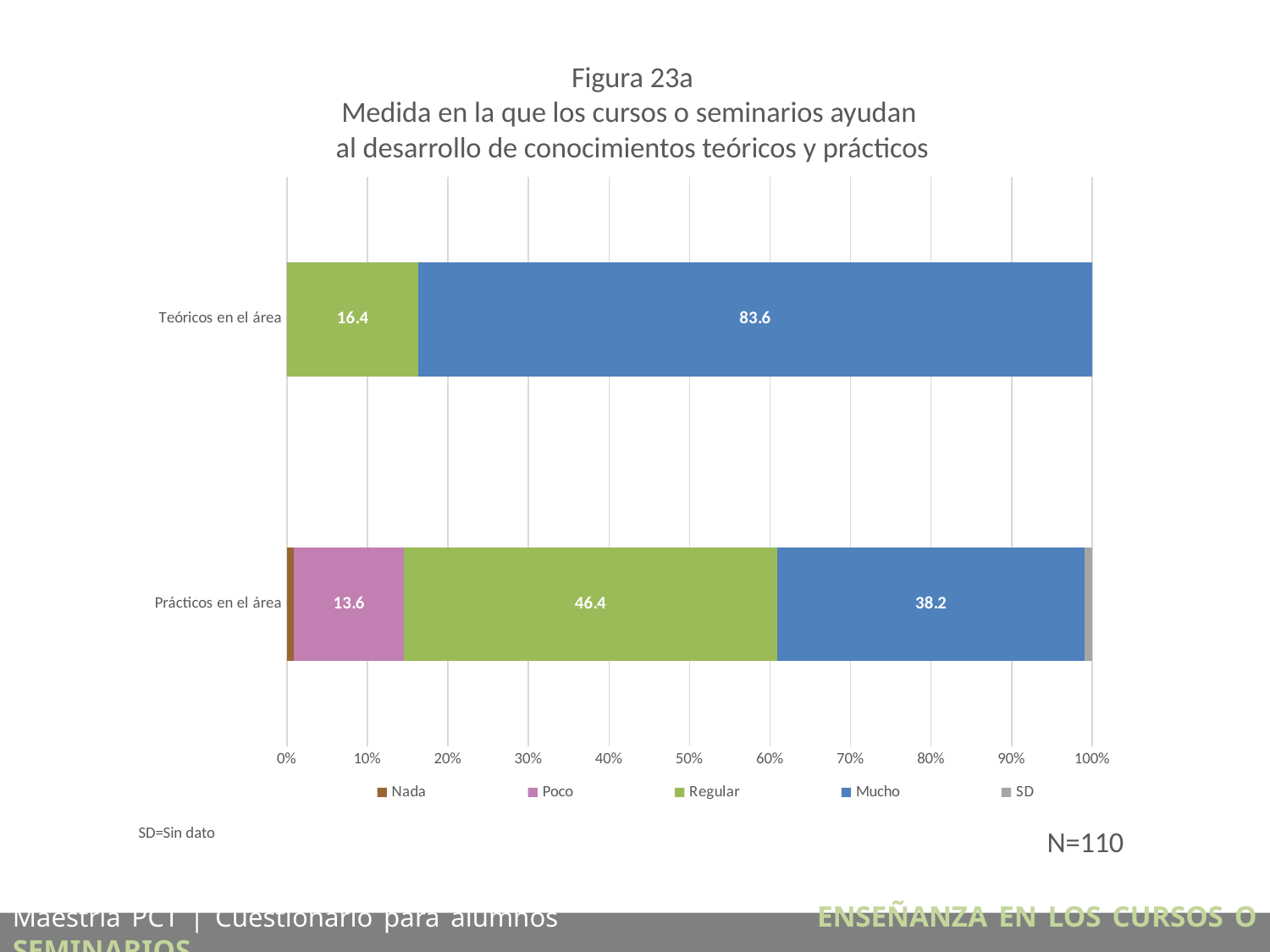
What is the value for Mucho in the Teóricos en el área bar? 83.6 How many categories are shown on the chart? 2 Which category has the larger value for Mucho, Teóricos en el área or Prácticos en el área? Teóricos en el área What is the value for Poco in the Prácticos en el área bar? 13.6 What is the value for Regular in the Prácticos en el área bar? 46.4 Is the value for Nada in the Prácticos en el área bar greater or less than 10%? less What is the value for Regular in the Teóricos en el área bar? 16.4 What is the difference between the Mucho values for Teóricos en el área and Prácticos en el área? 45.4 How many series does the legend list? 5 What kind of chart is shown on the slide? Stacked bar chart Which series has the largest segment in the Prácticos en el área bar? Regular According to the note below the chart, what does SD stand for? Sin dato